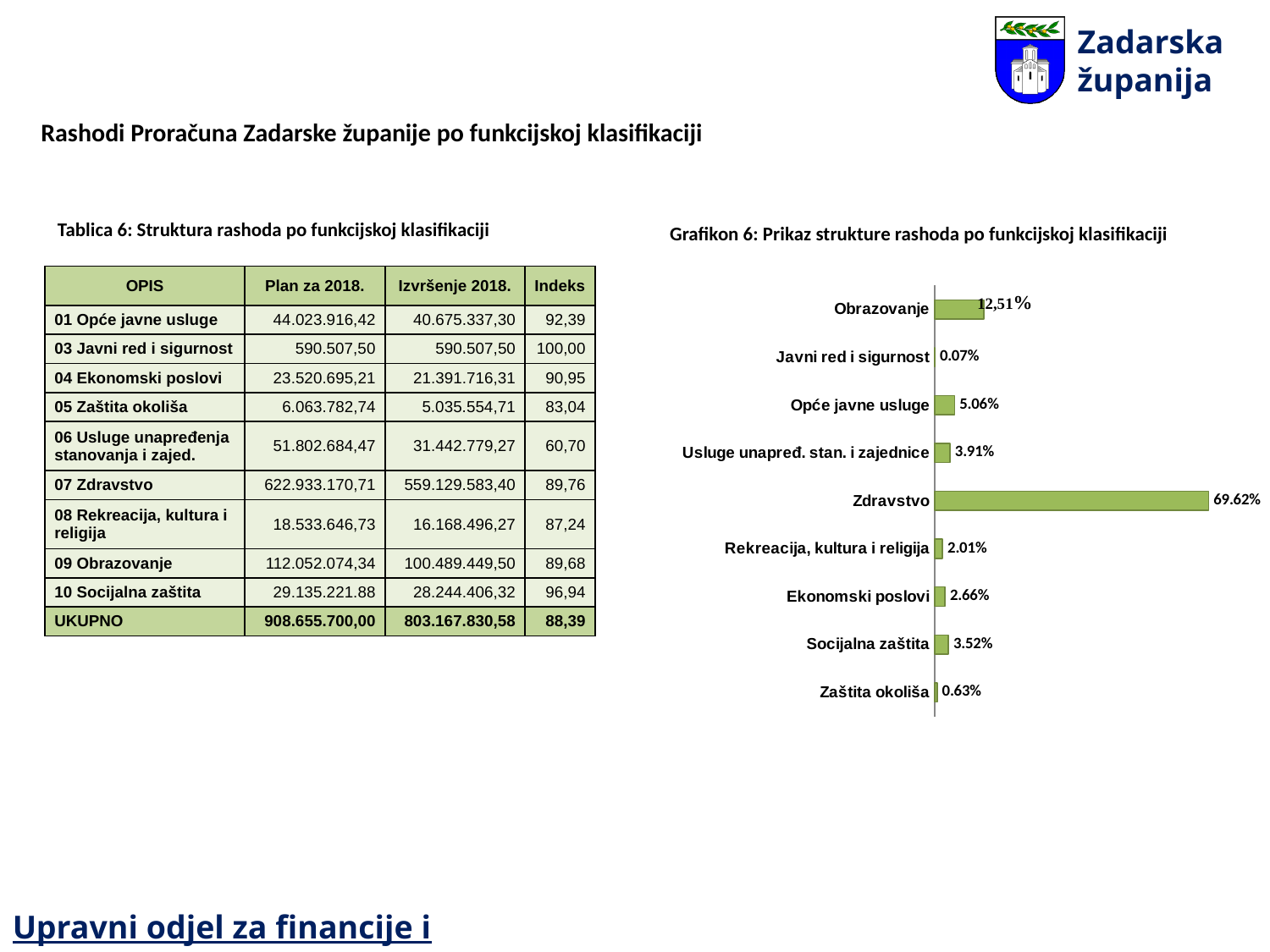
What is the title of the chart on the slide? Grafikon 6: Prikaz strukture rashoda po funkcijskoj klasifikaciji In Grafikon 6, what is the value shown for Zdravstvo? 69.62% In Grafikon 6, what is the value shown for Socijalna zaštita? 3.52% In Grafikon 6, which category has the highest value? Zdravstvo In Grafikon 6, how many categories are shown? 9 In Grafikon 6, what is the value shown for Javni red i sigurnost? 0.07% What kind of chart is Grafikon 6 on the slide? bar chart In Grafikon 6, which is larger: Opće javne usluge or Ekonomski poslovi? Opće javne usluge In Grafikon 6, which category has the lowest value? Javni red i sigurnost In Grafikon 6, what is the value shown for Obrazovanje? 12,51% In Grafikon 6, what is the difference between Socijalna zaštita and Ekonomski poslovi? 0.86% In Grafikon 6, what is the difference between Zdravstvo and Opće javne usluge? 64.56%